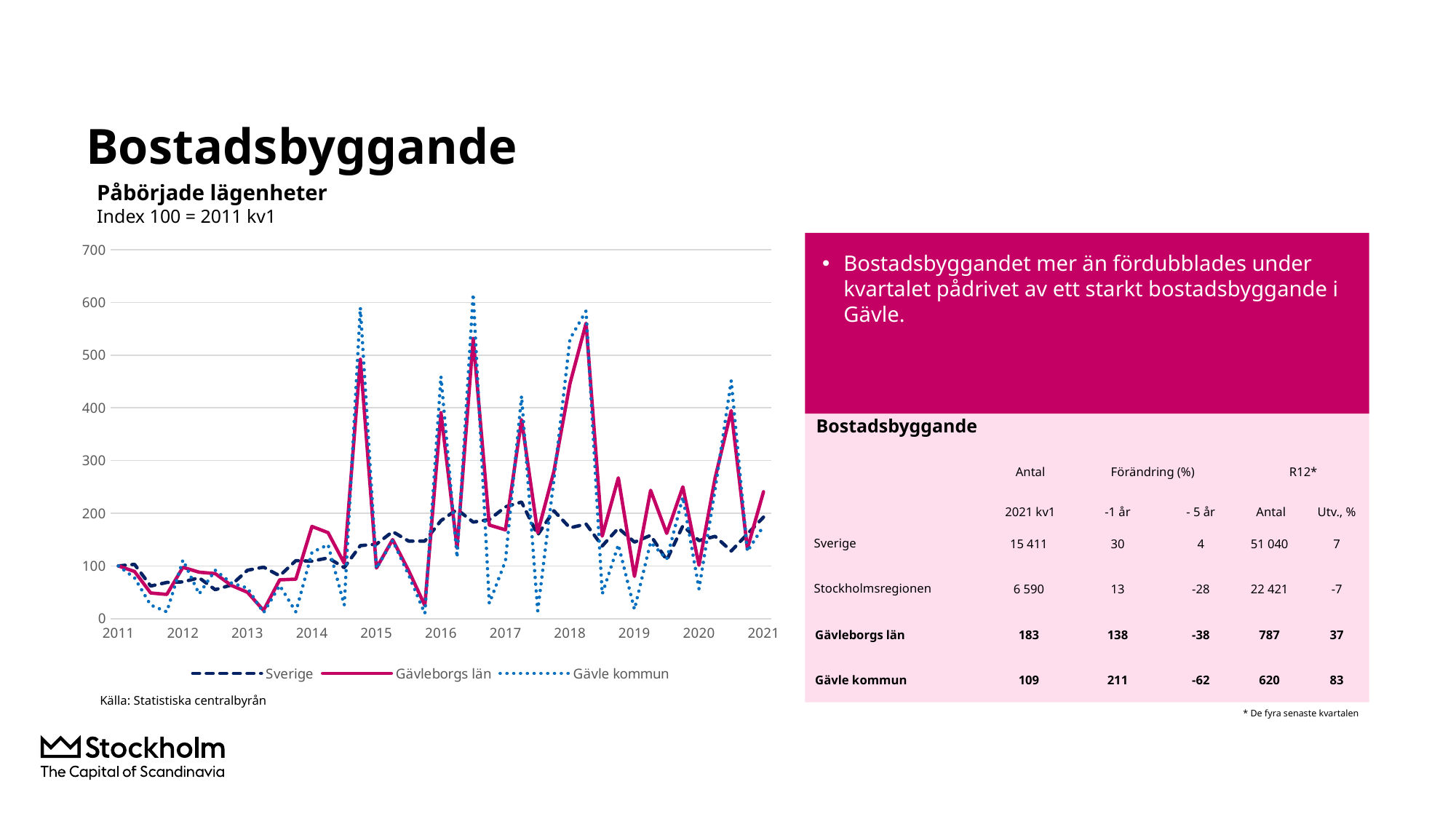
Is the highest peak of the Gävle kommun line greater or less than 600? greater Is the value of the Gävleborgs län line at 2021 greater or less than 200? greater What kind of chart is shown on the slide? Line chart How many series does the legend of the line chart list? 3 What is the index value for all three series at 2011 kv1 in the line chart? 100 Does the Sverige line end in 2021 higher or lower than it starts in 2011? Higher Is the highest value of the Sverige line greater or less than 300? less Which series reaches the highest value anywhere in the line chart? Gävle kommun What is the source given below the line chart? Statistiska centralbyrån How many year labels are shown on the x axis of the line chart? 11 Which series are listed in the legend of the line chart? Sverige, Gävleborgs län, Gävle kommun